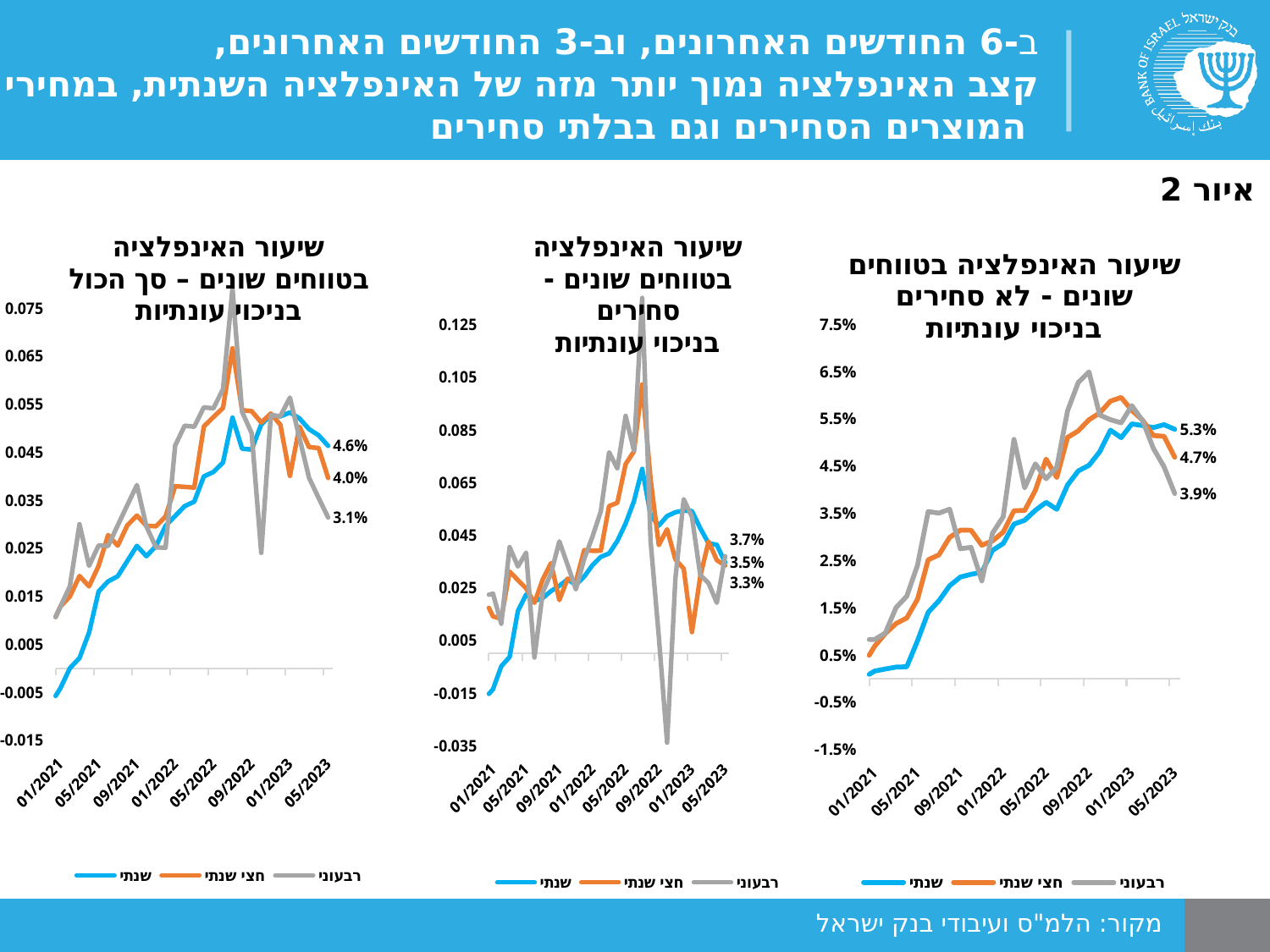
In the middle chart (סחירים בניכוי עונתיות), which of the three series has the lowest latest labelled value? חצי שנתי How many series does the legend of each chart list? 3 In the right chart (לא סחירים בניכוי עונתיות), what is the latest value labelled for the annual (שנתי) series? 5.3% In the left chart (סך הכול בניכוי עונתיות), what is the latest value labelled for the annual (שנתי) series? 4.6% In the right chart (לא סחירים בניכוי עונתיות), does the annual (שנתי) series generally rise or fall from 01/2021 to 01/2023? rise What type of chart is used for the three charts on the slide? line chart In the left chart (סך הכול בניכוי עונתיות), what is the difference between the latest annual (שנתי) value and the latest semi-annual (חצי שנתי) value? 0.6% Comparing the latest annual (שנתי) values, which chart shows the higher value: the middle chart (סחירים) or the right chart (לא סחירים)? the right chart (לא סחירים), 5.3% In the right chart (לא סחירים בניכוי עונתיות), what is the latest value labelled for the quarterly (רבעוני) series? 3.9% In the left chart (סך הכול בניכוי עונתיות), what is the latest value labelled for the quarterly (רבעוני) series? 3.1% In the right chart (לא סחירים בניכוי עונתיות), what is the difference between the latest annual (שנתי) value and the latest quarterly (רבעוני) value? 1.4% In the middle chart (סחירים בניכוי עונתיות), what is the latest value labelled for the semi-annual (חצי שנתי) series? 3.3%